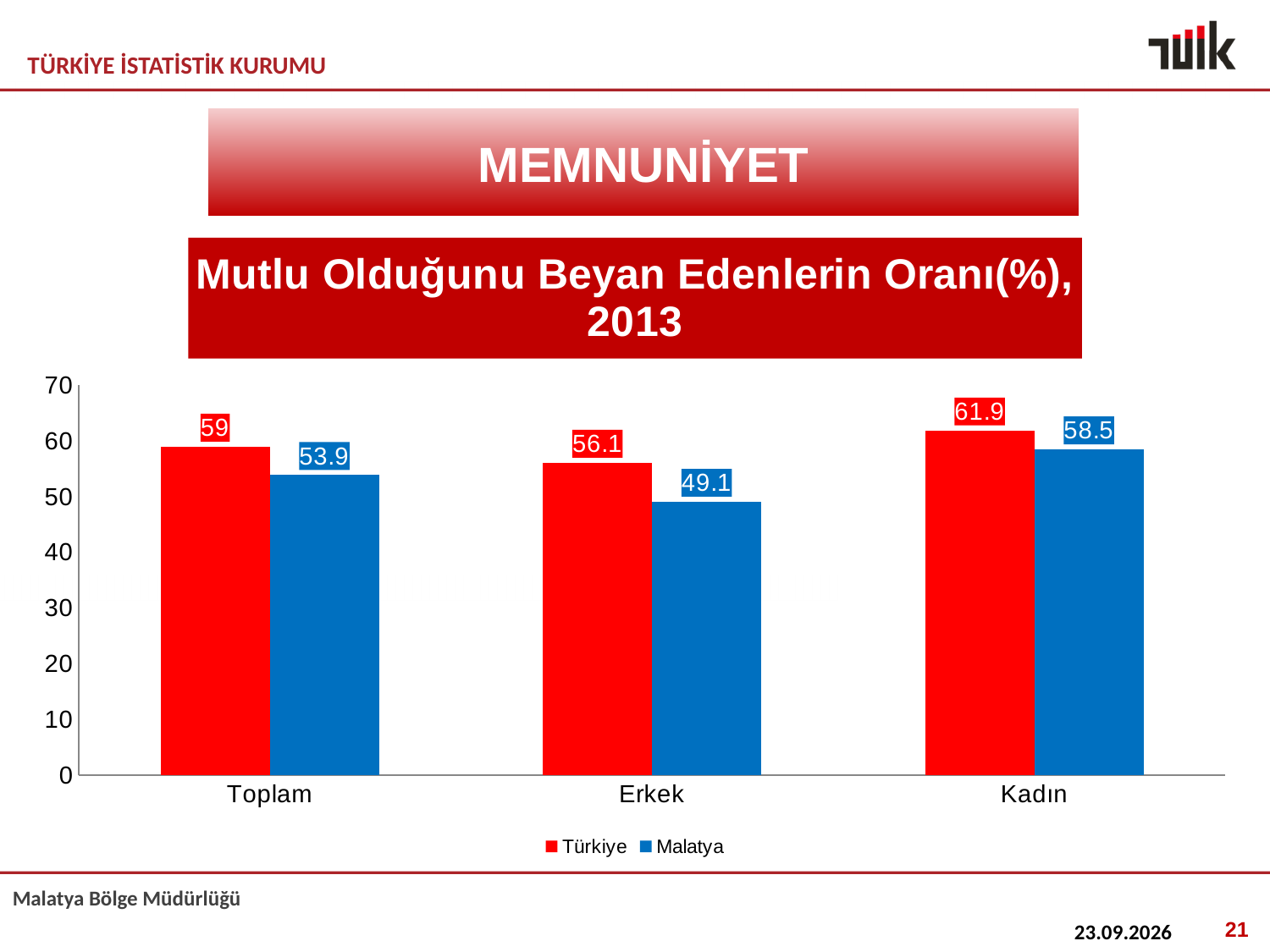
How many series does the legend list? 2 Which is larger in the Toplam category, Türkiye or Malatya? Türkiye What is the difference between the Kadın and Erkek values for Malatya? 9.4 How many categories are shown on the x axis? 3 What is the value for Malatya in the Kadın category? 58.5 Which category has the highest value for Türkiye? Kadın Which category has the lowest value for Malatya? Erkek What is the value for Türkiye in the Toplam category? 59 What is the difference between the Türkiye and Malatya values in the Erkek category? 7 What is the value for Malatya in the Erkek category? 49.1 Is the value for Malatya in the Erkek category greater or less than 50? less What kind of chart is shown on the slide? bar chart